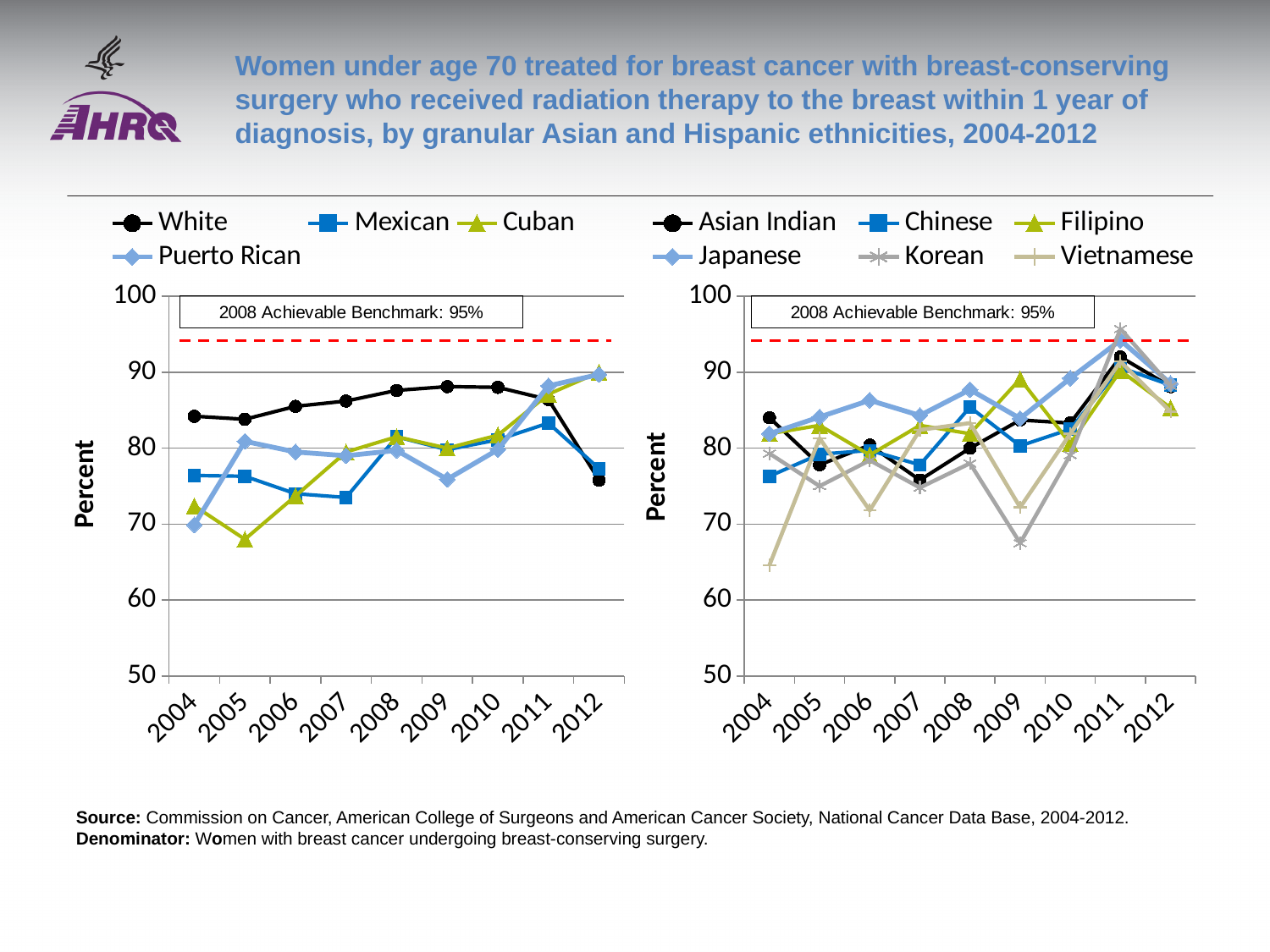
How many series does the legend of the left chart list? 4 In the left chart, is the value for Cuban in 2005 greater or less than 70? less What kind of chart is the left chart on the slide? line chart How many years are shown along the x axis of the right chart? 9 In the right chart, is the value for Korean in 2011 greater or less than 90? greater How many series does the legend of the right chart list? 6 In the right chart, is the value for Vietnamese in 2004 greater or less than 70? less In the right chart, which is larger in 2009, the value for Filipino or the value for Korean? Filipino In the left chart, which group has the lowest value in 2005? Cuban In the left chart, which is larger in 2004, the value for White or the value for Puerto Rican? White What is the 2008 Achievable Benchmark shown on both charts? 95%